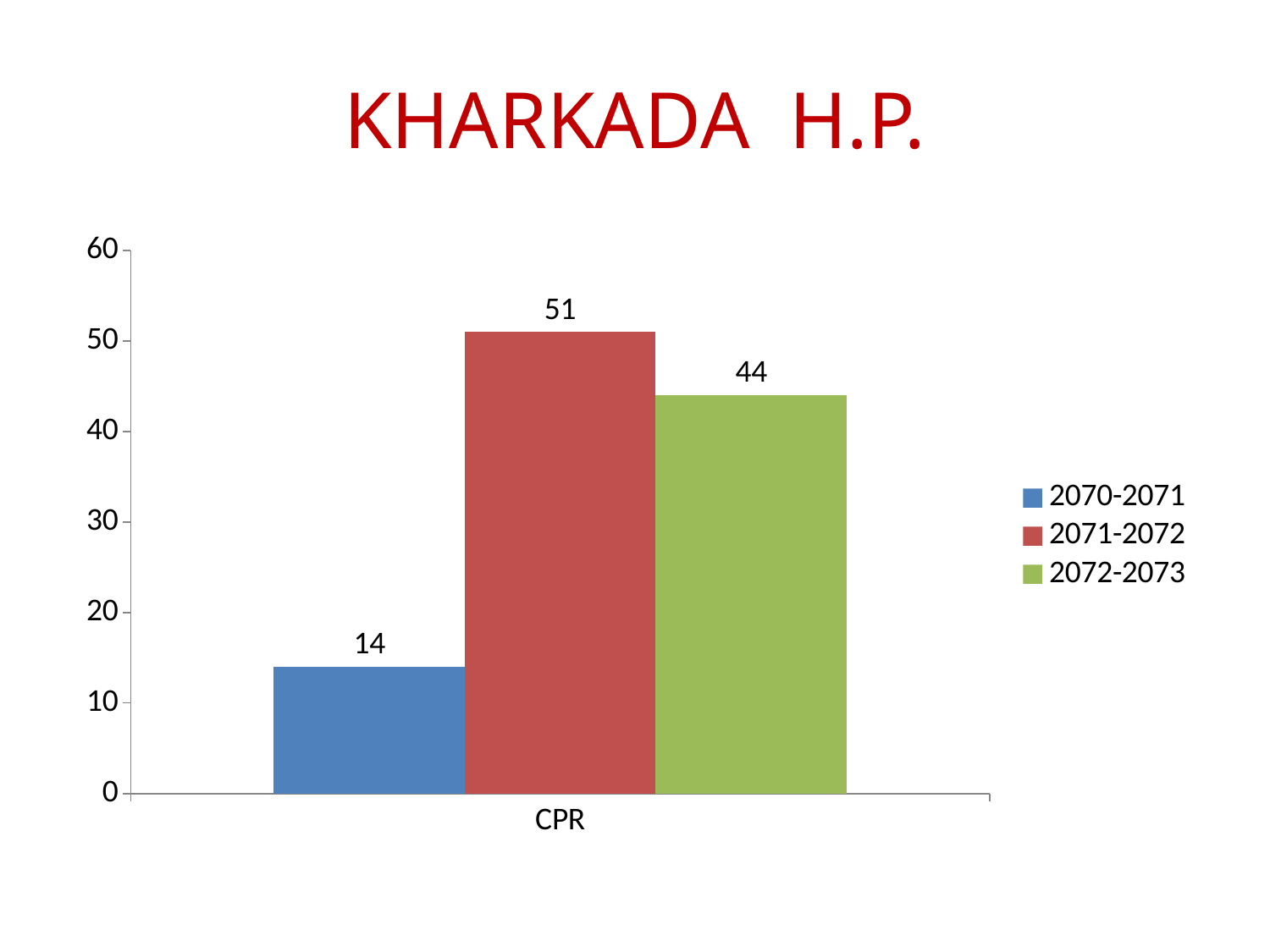
What is the CPR value for 2072-2073? 44 Which year series has the lowest CPR value? 2070-2071 Which is larger, the CPR value for 2072-2073 or for 2070-2071? 2072-2073 What is the difference between the CPR values for 2071-2072 and 2070-2071? 37 What is the title of the slide? KHARKADA H.P. What is the CPR value for 2070-2071? 14 How many series does the legend list? 3 What is the difference between the CPR values for 2071-2072 and 2072-2073? 7 Is the CPR value for 2072-2073 greater or less than 40? greater Which year series has the highest CPR value? 2071-2072 What kind of chart is shown on the slide? bar chart What is the CPR value for 2071-2072? 51